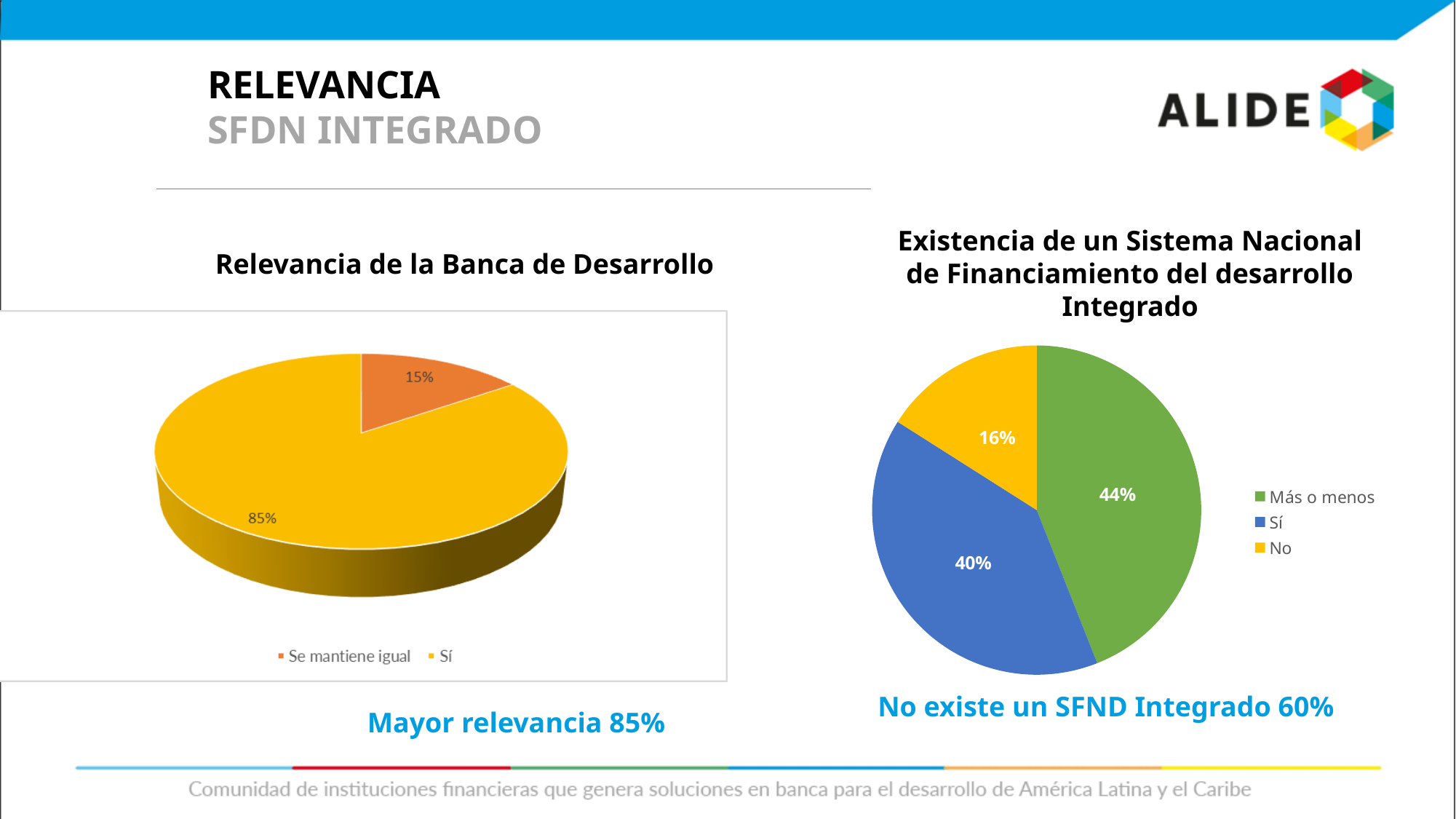
In the 'Relevancia de la Banca de Desarrollo' chart, what share does 'Se mantiene igual' have? 15% In the 'Relevancia de la Banca de Desarrollo' chart, what is the difference between the 'Sí' and 'Se mantiene igual' shares? 70% How many categories does the legend of the 'Relevancia de la Banca de Desarrollo' chart list? 2 In the 'Existencia de un Sistema Nacional de Financiamiento del desarrollo Integrado' chart, which category has the largest slice? Más o menos In the 'Existencia de un Sistema Nacional de Financiamiento del desarrollo Integrado' chart, what colour is the 'No' slice? Yellow In the 'Relevancia de la Banca de Desarrollo' chart, which category has the largest slice? Sí In the 'Existencia de un Sistema Nacional de Financiamiento del desarrollo Integrado' chart, which category has the smallest slice? No In the 'Existencia de un Sistema Nacional de Financiamiento del desarrollo Integrado' chart, what share does 'Sí' have? 40% What kind of chart is 'Relevancia de la Banca de Desarrollo'? Pie chart In the 'Existencia de un Sistema Nacional de Financiamiento del desarrollo Integrado' chart, what share does 'No' have? 16% In the 'Existencia de un Sistema Nacional de Financiamiento del desarrollo Integrado' chart, what is the difference between the 'Más o menos' and 'Sí' shares? 4%